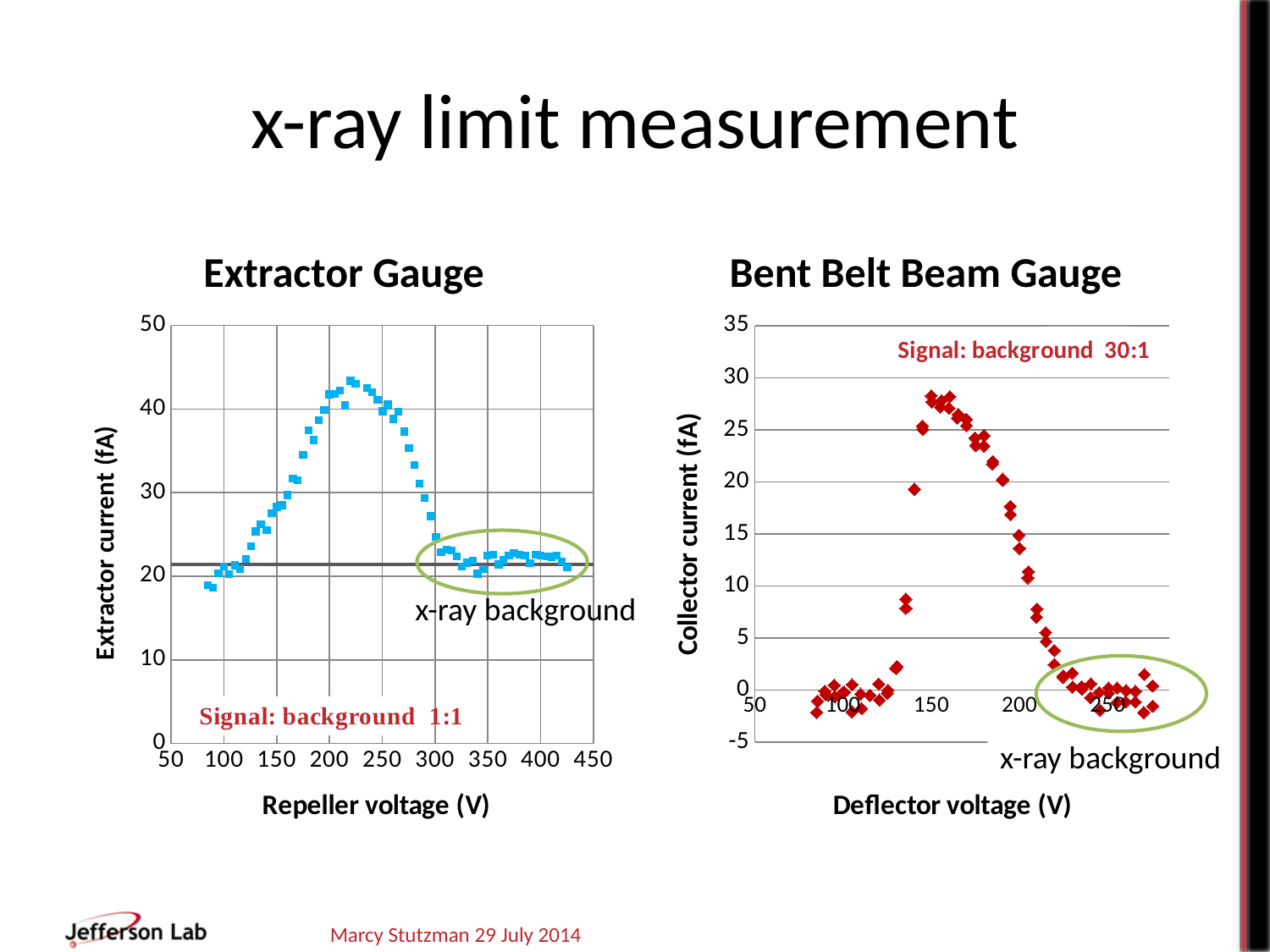
In the Bent Belt Beam Gauge chart, is the collector current at a deflector voltage of 100 V greater or less than 5? less In the Extractor Gauge chart, is the highest extractor current value greater or less than 40? greater What kind of chart is the Bent Belt Beam Gauge chart? scatter chart In the Bent Belt Beam Gauge chart, is the highest collector current value greater or less than 25? greater What is the x-axis title of the Extractor Gauge chart? Repeller voltage (V) What signal-to-background ratio is stated on the Bent Belt Beam Gauge chart? 30:1 What kind of chart is the Extractor Gauge chart? scatter chart In the Extractor Gauge chart, do the extractor current values rise or fall as the repeller voltage increases from 100 V to 200 V? rise In the Bent Belt Beam Gauge chart, do the collector current values rise or fall as the deflector voltage increases from 150 V to 250 V? fall